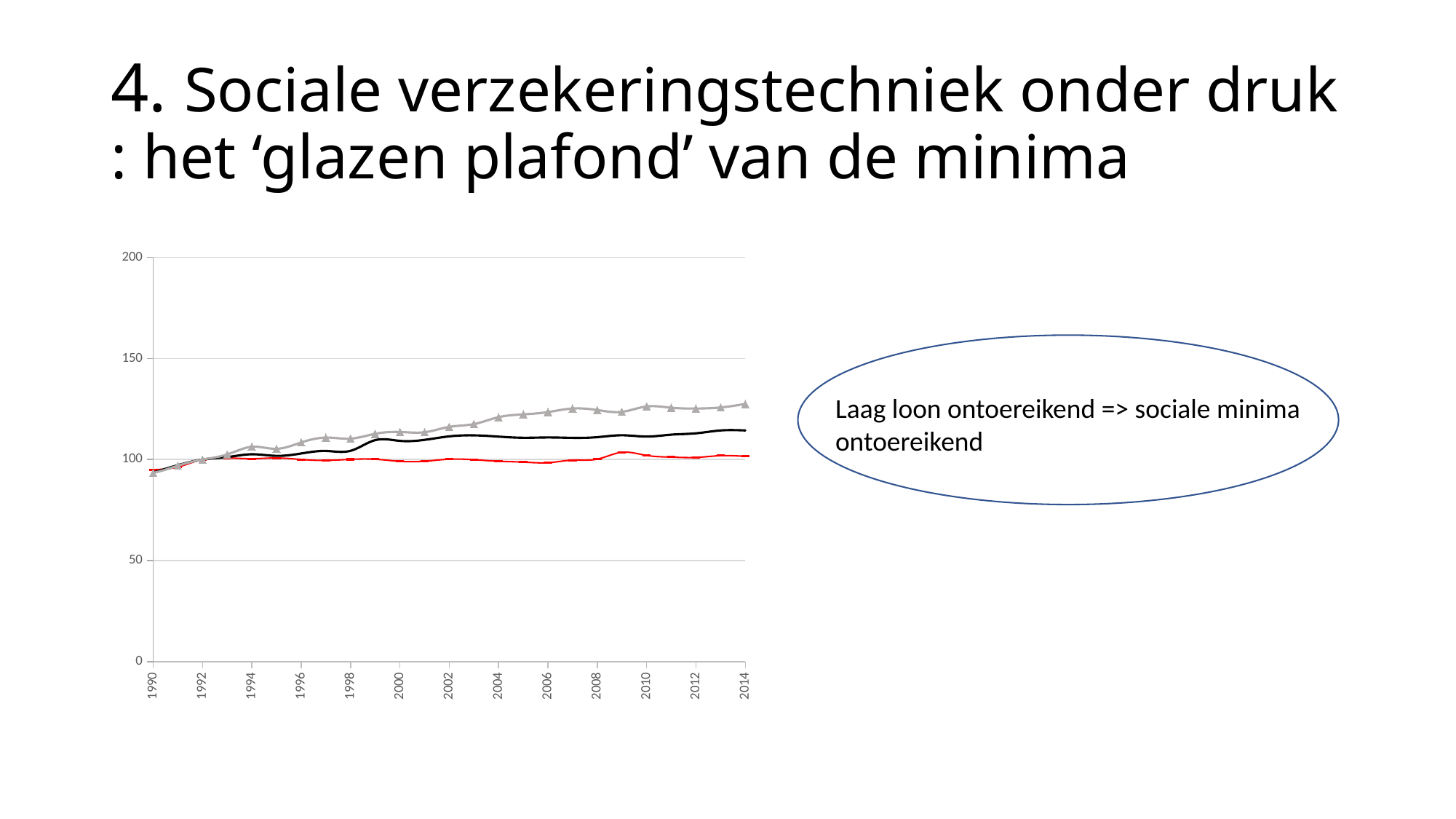
How many lines are plotted on the chart? 3 Which line has the highest value in 2014? the grey line with triangle markers Is the value of the grey line with triangle markers in 2014 greater or less than 100? greater Is the value of the black line in 2014 greater or less than 100? greater Which line has the lowest value in 2014? the red line Is the value of the black line in 2014 greater or less than 150? less Does the grey line with triangle markers rise or fall from 1990 to 2014? rise What is the last year shown on the x axis? 2014 What kind of chart is shown on the slide? line chart In 2010, which is higher: the grey line with triangle markers or the red line? the grey line with triangle markers What is the first year shown on the x axis? 1990